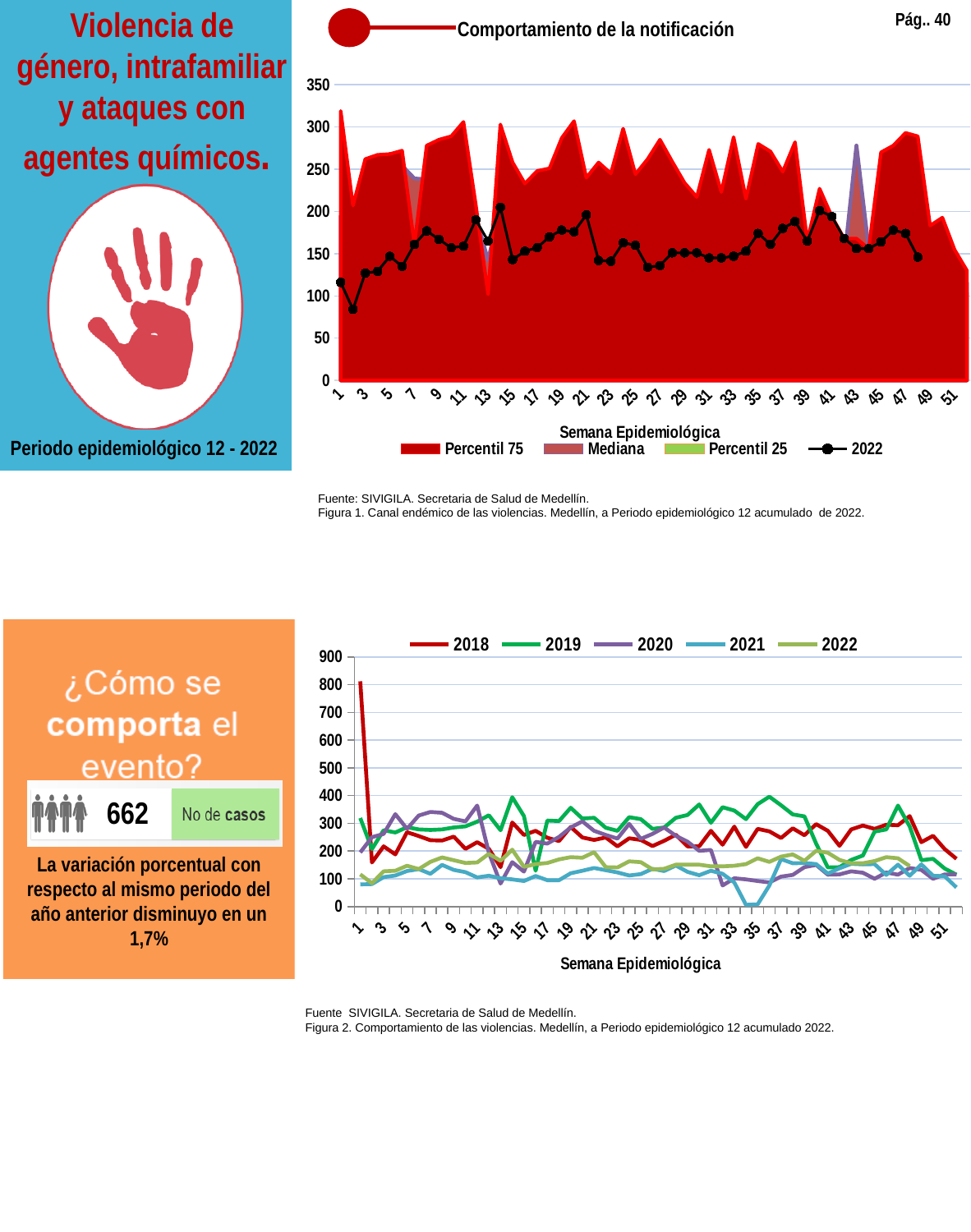
In the bottom chart (Figura 2), is the 2018 value at week 1 greater or less than 700? greater In the top chart 'Comportamiento de la notificación', at which week does the 2022 line reach its lowest value? 2 In the top chart 'Comportamiento de la notificación', is the Percentil 75 value at week 1 greater or less than 300? greater In the top chart 'Comportamiento de la notificación', at week 2, which is larger: the Percentil 75 value or the 2022 value? Percentil 75 What is the x-axis title of the top chart 'Comportamiento de la notificación'? Semana Epidemiológica In the top chart 'Comportamiento de la notificación', what are the four legend entries? Percentil 75, Mediana, Percentil 25, 2022 In the bottom chart (Figura 2), at week 1, which series has the larger value: 2018 or 2019? 2018 How many series does the legend of the bottom chart (Figura 2) list? 5 In the bottom chart (Figura 2), is the 2021 value at week 35 greater or less than 100? less What kind of chart is the bottom chart (Figura 2)? line chart How many series does the legend of the top chart 'Comportamiento de la notificación' list? 4